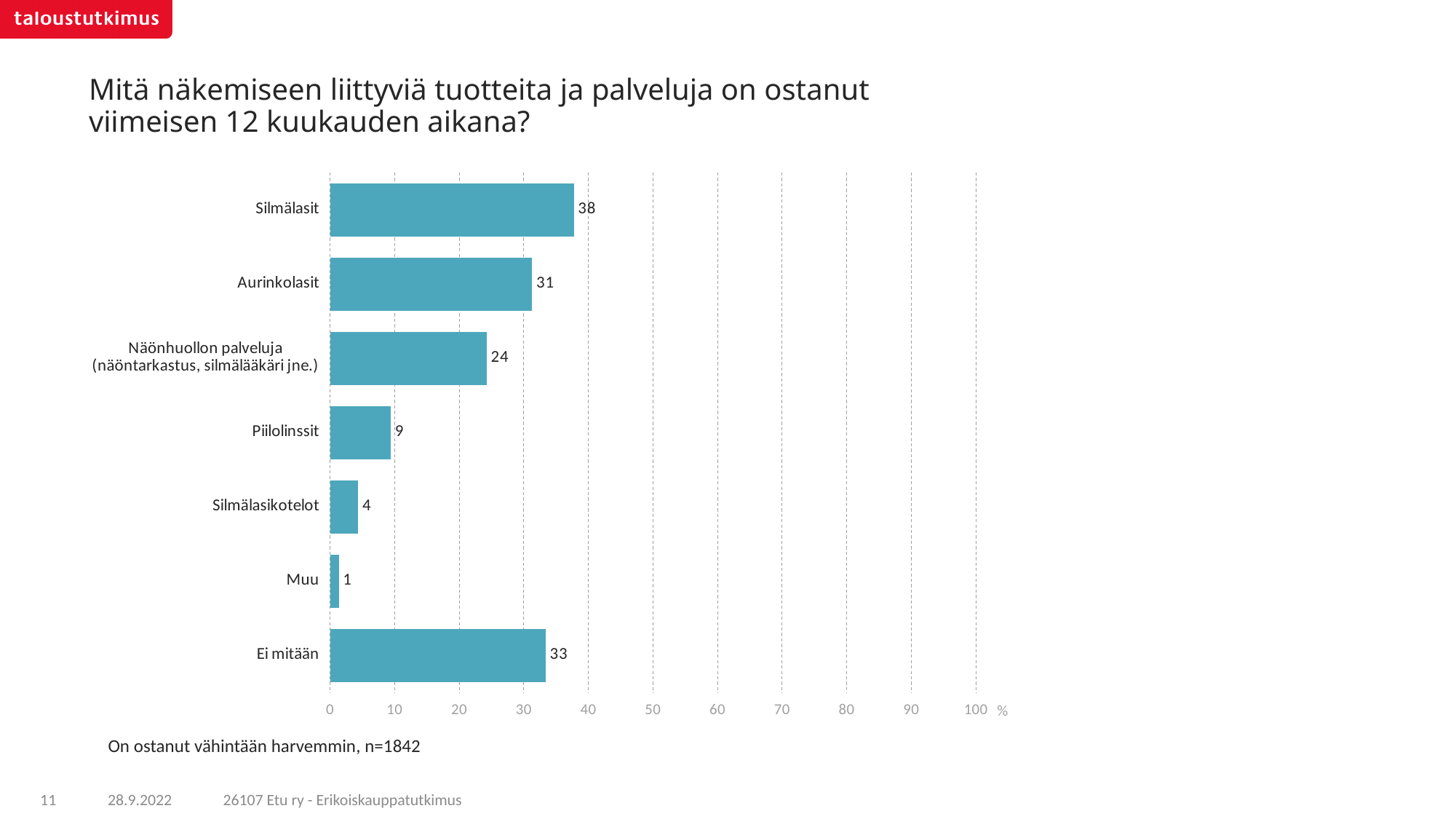
Which category has the highest value? Silmälasit What is the value for Silmälasit? 38 Which category has the lowest value? Muu What is the sample size (n) stated below the chart? n=1842 What is the difference between the values for Silmälasit and Aurinkolasit? 7 What is the value for Aurinkolasit? 31 Which is larger, the value for Ei mitään or the value for Aurinkolasit? Ei mitään What is the value for Näönhuollon palveluja (näöntarkastus, silmälääkäri jne.)? 24 What kind of chart is shown on the slide? Bar chart What is the value for Ei mitään? 33 How many categories are shown in the chart? 7 What is the value for Piilolinssit? 9